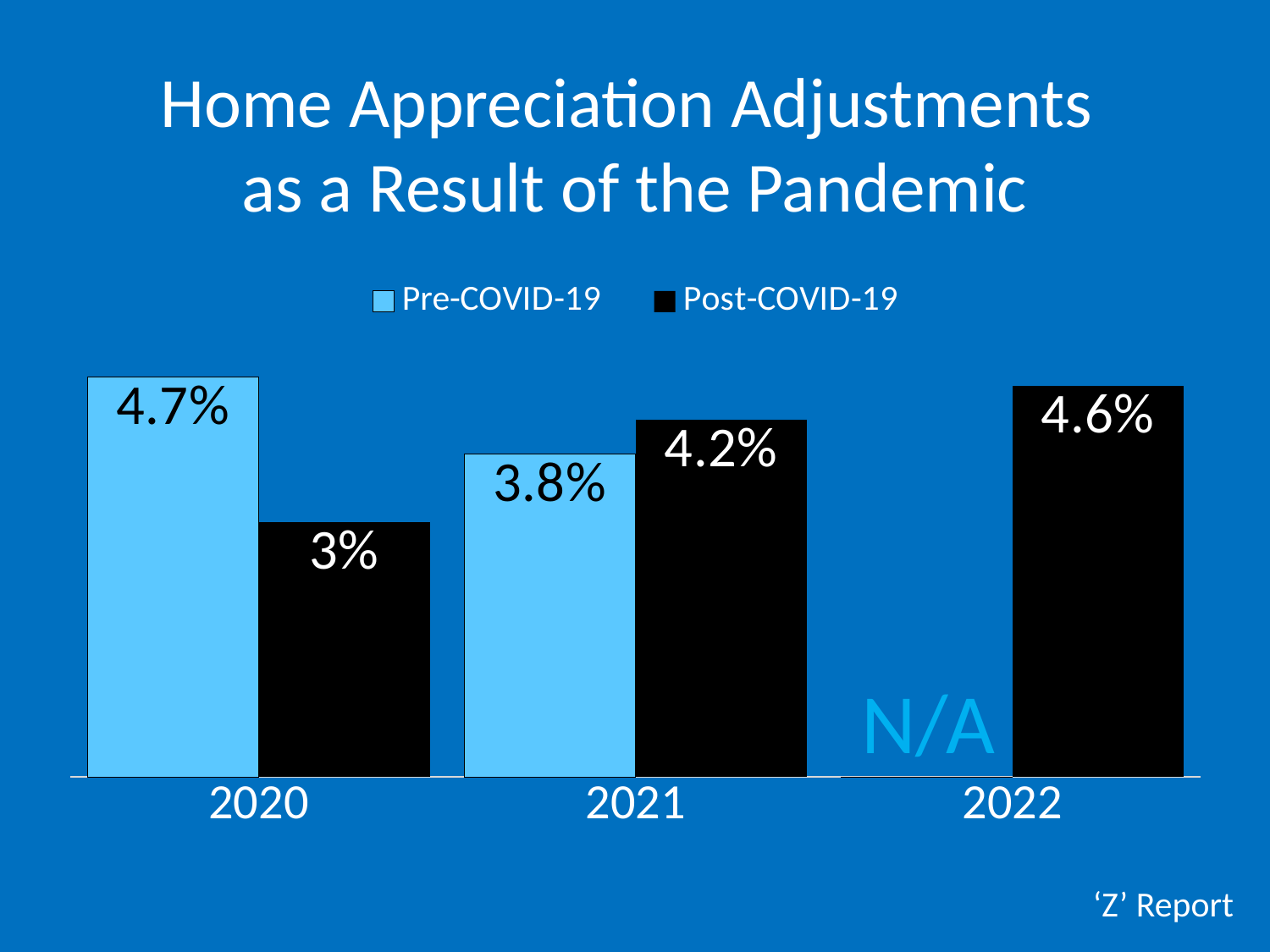
What is the Pre-COVID-19 value for 2020? 4.7% What is the difference between the Pre-COVID-19 and Post-COVID-19 values for 2020? 1.7% What is the Pre-COVID-19 value for 2022? N/A What is the Post-COVID-19 value for 2021? 4.2% How many series does the legend list? 2 Which year has the highest Post-COVID-19 value? 2022 For 2021, which is larger: the Pre-COVID-19 value or the Post-COVID-19 value? Post-COVID-19 How many years are shown on the x axis? 3 What kind of chart is shown on the slide? Bar chart Do the Post-COVID-19 values rise or fall from 2020 to 2022? Rise What is the Post-COVID-19 value for 2022? 4.6% Which year has the lowest Post-COVID-19 value? 2020